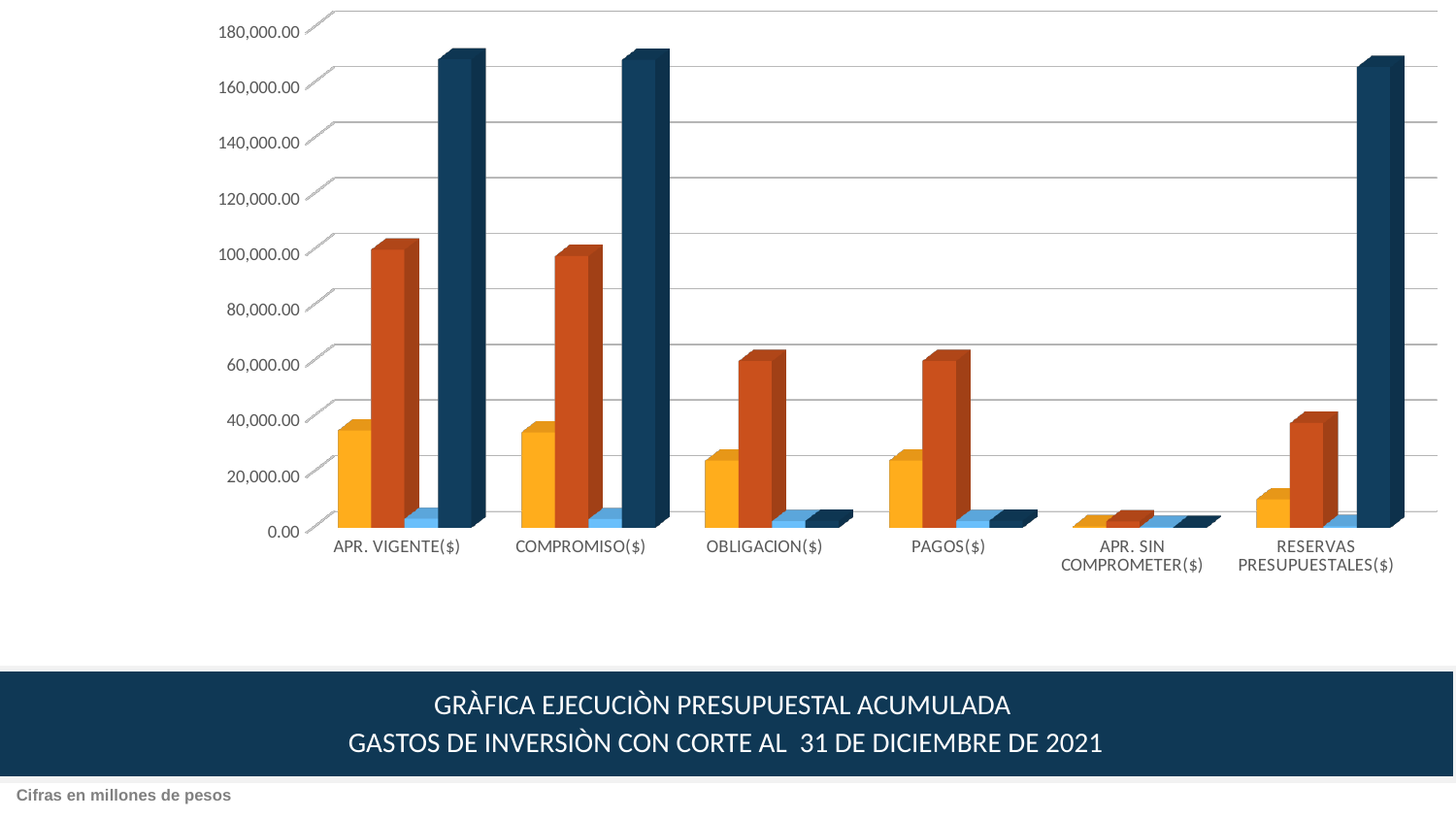
What is the highest value shown on the chart's vertical axis? 180,000.00 Is the value of the yellow bar for OBLIGACION($) greater or less than 40,000.00? less In the PAGOS($) category, which is larger: the yellow bar or the orange bar? the orange bar Is the value of the yellow bar for APR. VIGENTE($) greater or less than 40,000.00? less Which is larger: the orange bar for APR. VIGENTE($) or the orange bar for OBLIGACION($)? APR. VIGENTE($) How many bars are plotted for each category in the chart? 4 Which category has the lowest orange bar? APR. SIN COMPROMETER($) Is the value of the dark blue bar for OBLIGACION($) greater or less than 20,000.00? less What kind of chart is shown on the slide? bar chart How many categories are shown on the x axis of the chart? 6